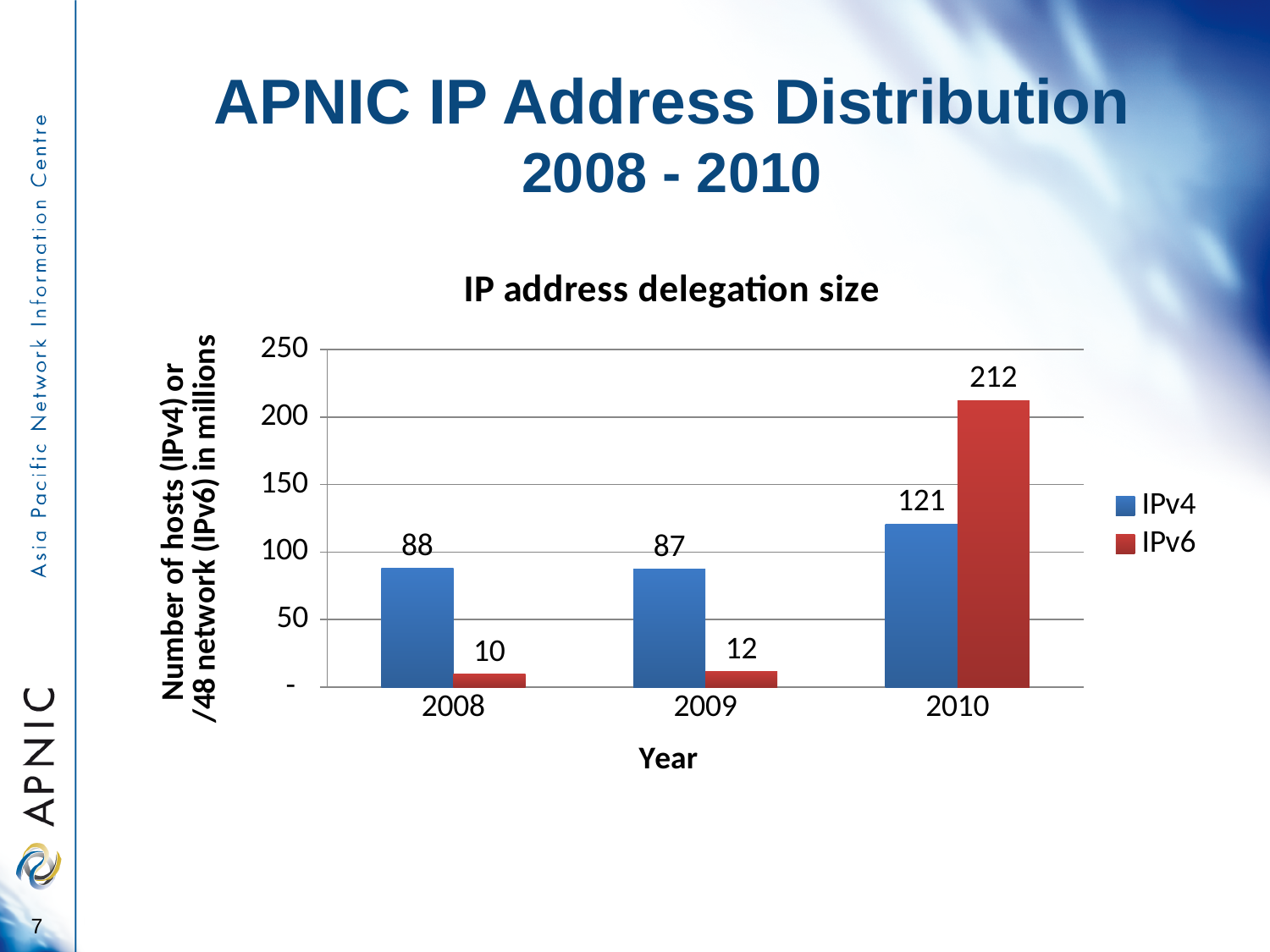
In which year is the IPv6 value lowest? 2008 How many series does the legend list? 2 What is the difference between the IPv6 and IPv4 values in 2010? 91 What is the IPv6 value for 2010? 212 How many years are shown on the x axis? 3 What is the IPv4 value for 2008? 88 What is the IPv4 value for 2010? 121 Which is larger in 2009, the IPv4 value or the IPv6 value? IPv4 In which year is the IPv6 value highest? 2010 What kind of chart is shown on the slide? Bar chart What is the IPv6 value for 2009? 12 What is the title of the chart? IP address delegation size